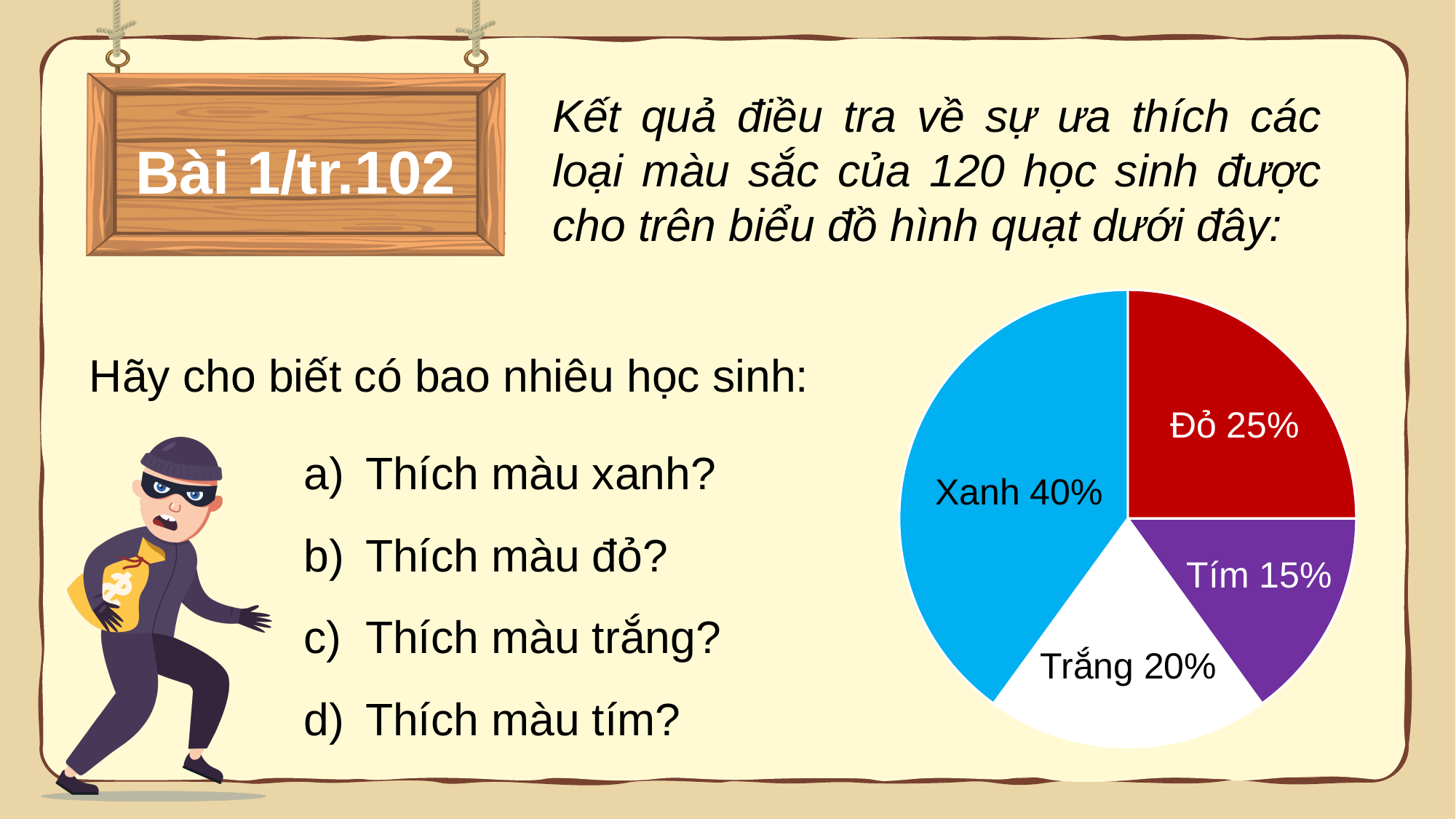
Which slice of the pie chart is the smallest? Tím Which slice of the pie chart is the largest? Xanh What percentage of the pie chart is labelled Tím? 15% What percentage of the pie chart is labelled Trắng? 20% What is the difference in percentage points between the Xanh slice and the Đỏ slice? 15% How many slices does the pie chart have? 4 What kind of chart is shown on the slide? pie chart What percentage of the pie chart is labelled Xanh? 40% What percentage of the pie chart is labelled Đỏ? 25% What colour is the Xanh slice drawn in on the pie chart? blue Which slice is larger, Trắng or Tím? Trắng What is the combined share of the Đỏ and Tím slices? 40%